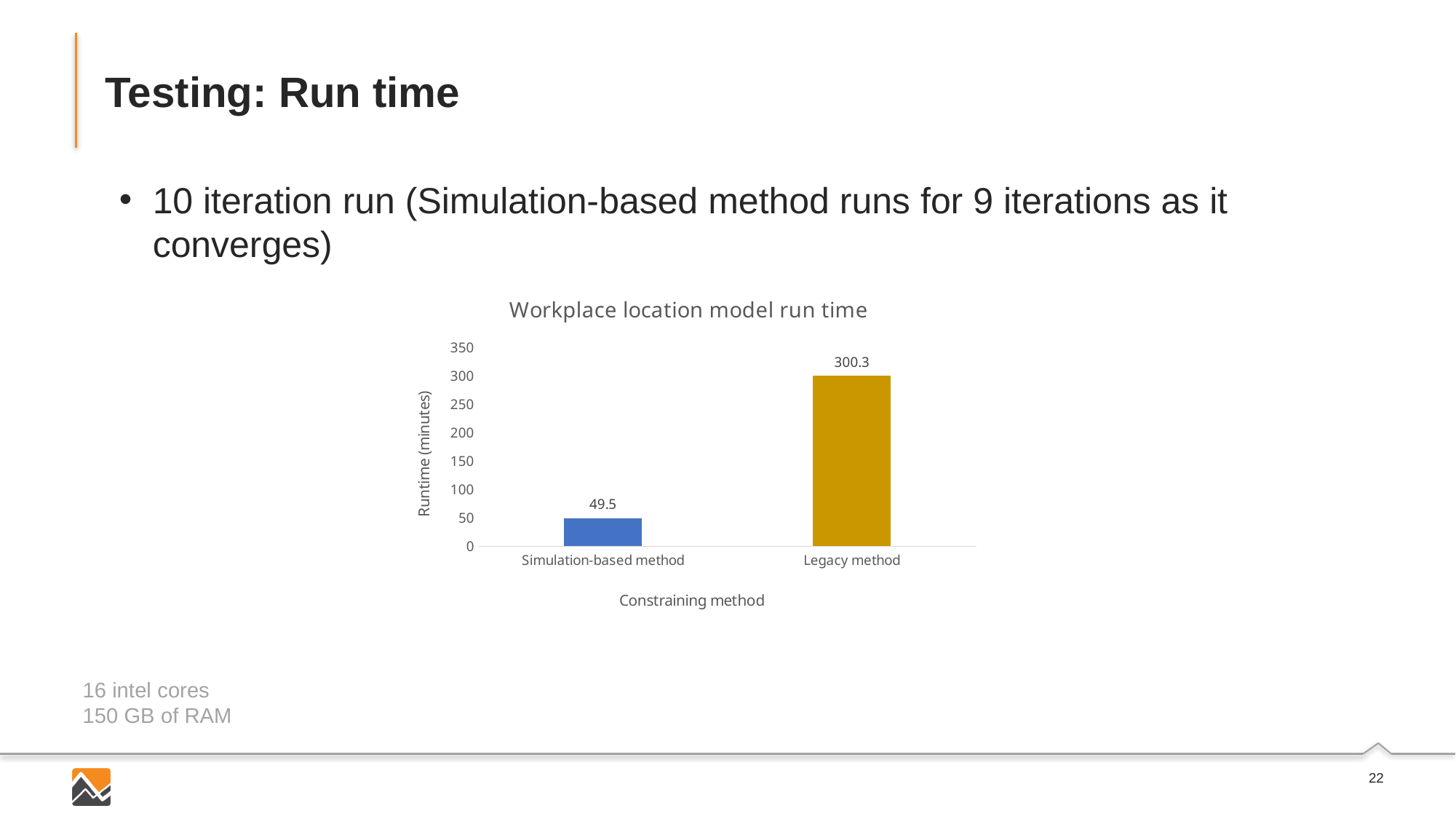
What is the runtime for the Simulation-based method? 49.5 What is the difference in runtime between the Legacy method and the Simulation-based method? 250.8 What kind of chart is shown on the slide? Bar chart Which constraining method has the highest runtime? Legacy method Is the runtime for the Legacy method greater or less than 250? greater What is the title of the chart? Workplace location model run time Which has a larger runtime, the Simulation-based method or the Legacy method? Legacy method How many constraining methods are shown in the chart? 2 What is the label of the vertical axis? Runtime (minutes) Is the runtime for the Simulation-based method greater or less than 100? less What is the runtime for the Legacy method? 300.3 Which constraining method has the lowest runtime? Simulation-based method